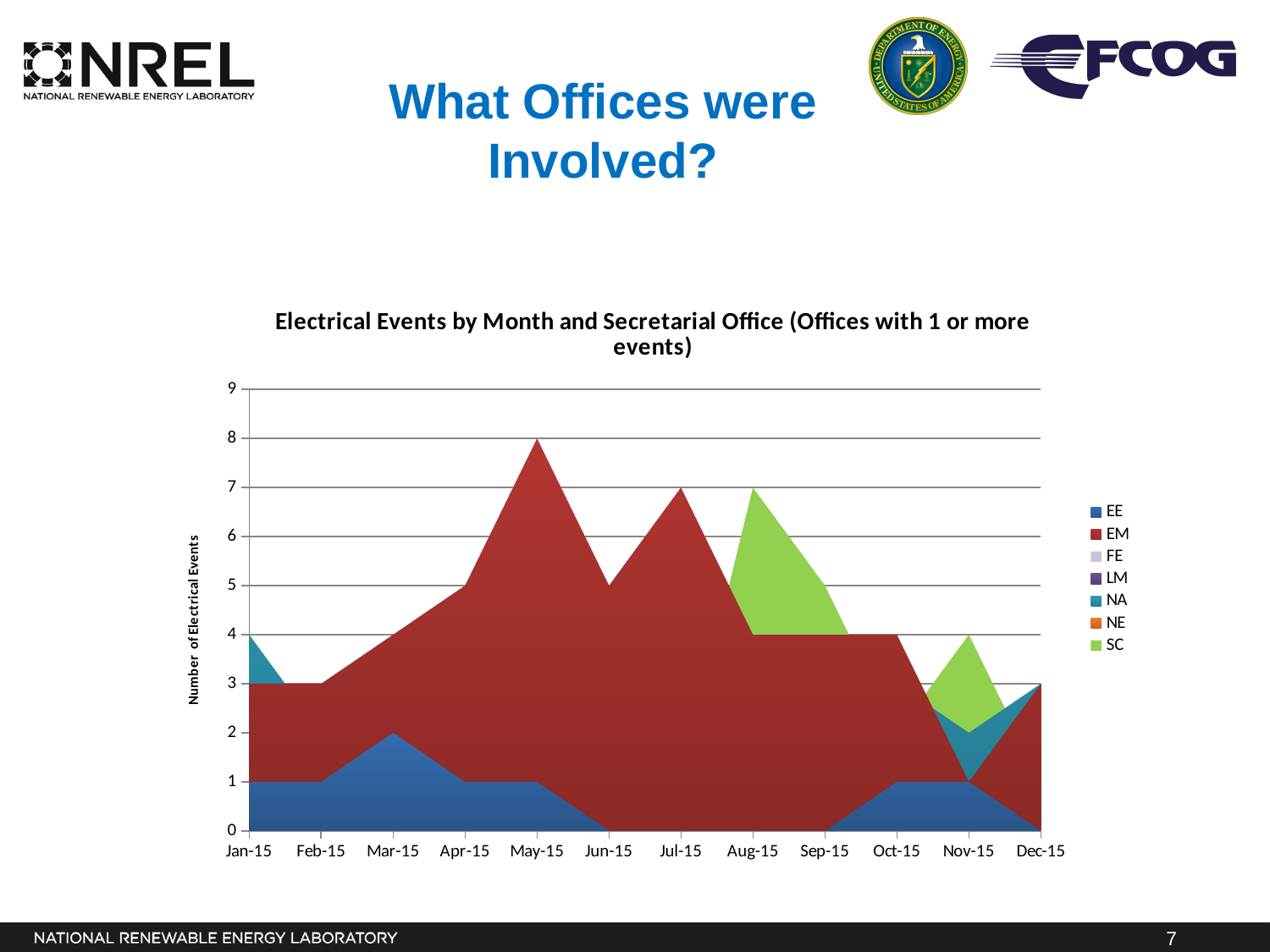
How many months are shown along the x axis? 12 Does the total number of events rise or fall from Jan-15 to May-15? rise What is the label on the y axis? Number of Electrical Events Is the total number of events in Apr-15 greater or less than 4? greater What kind of chart is shown on the slide? Area chart How many series does the legend list? 7